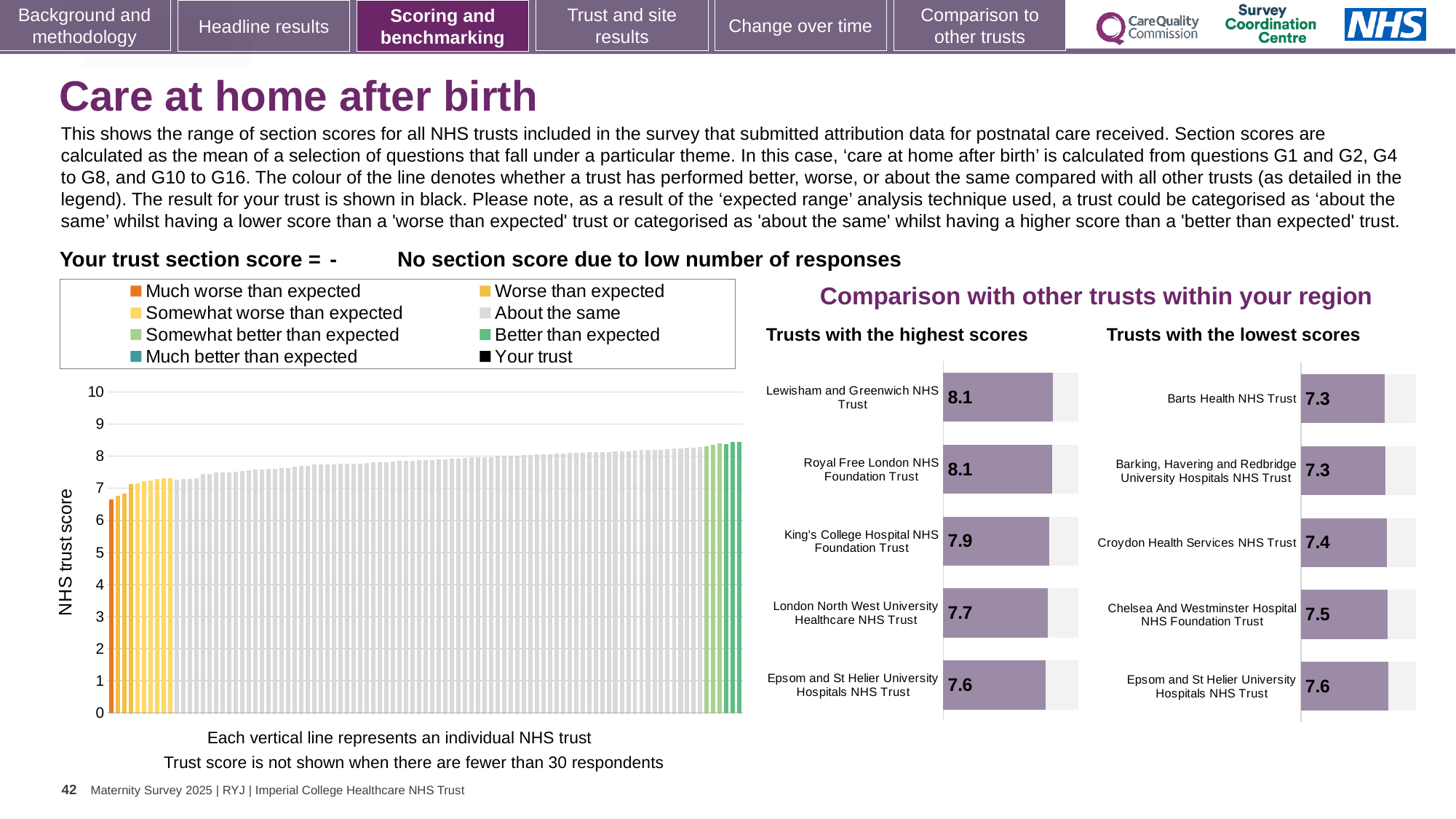
In the 'Trusts with the lowest scores' chart, which trust has the highest score? Epsom and St Helier University Hospitals NHS Trust In the 'Trusts with the lowest scores' chart, what is the score for Croydon Health Services NHS Trust? 7.4 In the large chart on the left showing all NHS trusts, do the values rise or fall from left to right? rise In the 'Trusts with the highest scores' chart, what is the score for Lewisham and Greenwich NHS Trust? 8.1 How many entries does the legend above the large chart on the left list? 8 In the 'Trusts with the highest scores' chart, what is the score for King's College Hospital NHS Foundation Trust? 7.9 In the 'Trusts with the highest scores' chart, what is the difference between the scores of King's College Hospital NHS Foundation Trust and Epsom and St Helier University Hospitals NHS Trust? 0.3 In the large chart on the left showing all NHS trusts, is the value of the leftmost (lowest) bar greater or less than 7? less In the 'Trusts with the lowest scores' chart, what is the score for Chelsea And Westminster Hospital NHS Foundation Trust? 7.5 How many trusts are shown in the 'Trusts with the highest scores' chart? 5 In the 'Trusts with the lowest scores' chart, which has the larger score: Barts Health NHS Trust or Chelsea And Westminster Hospital NHS Foundation Trust? Chelsea And Westminster Hospital NHS Foundation Trust In the 'Trusts with the highest scores' chart, which trust has the lowest score? Epsom and St Helier University Hospitals NHS Trust